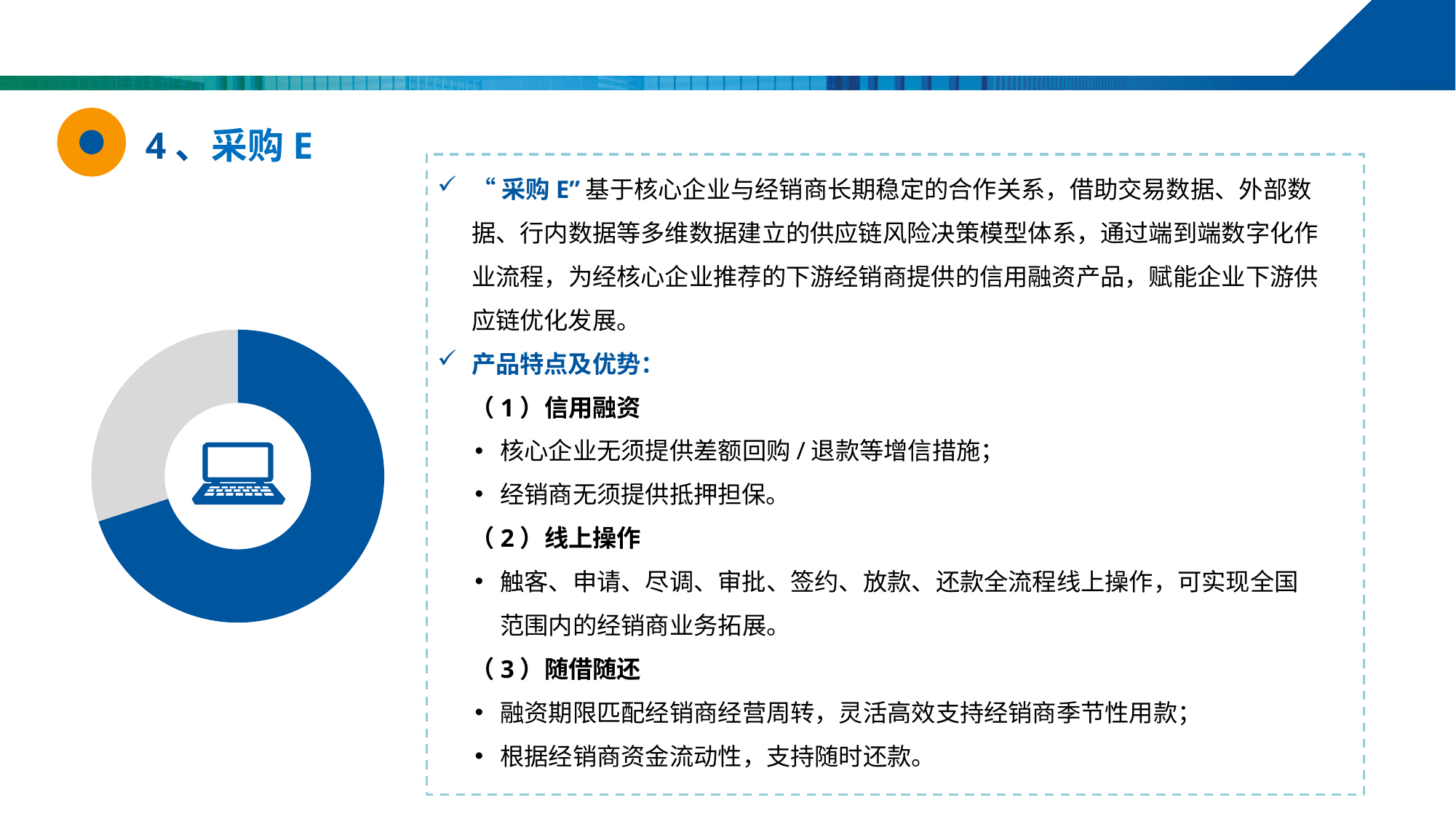
Does the doughnut chart on the left display any data labels or a legend? No In the doughnut chart on the left, which slice is larger, the blue one or the grey one? The blue one How many slices does the doughnut chart on the left contain? 2 What icon is placed in the centre of the doughnut chart on the left? A laptop What kind of chart is shown on the left of the slide? Doughnut (pie) chart In the doughnut chart on the left, which slice is the smallest? The grey slice